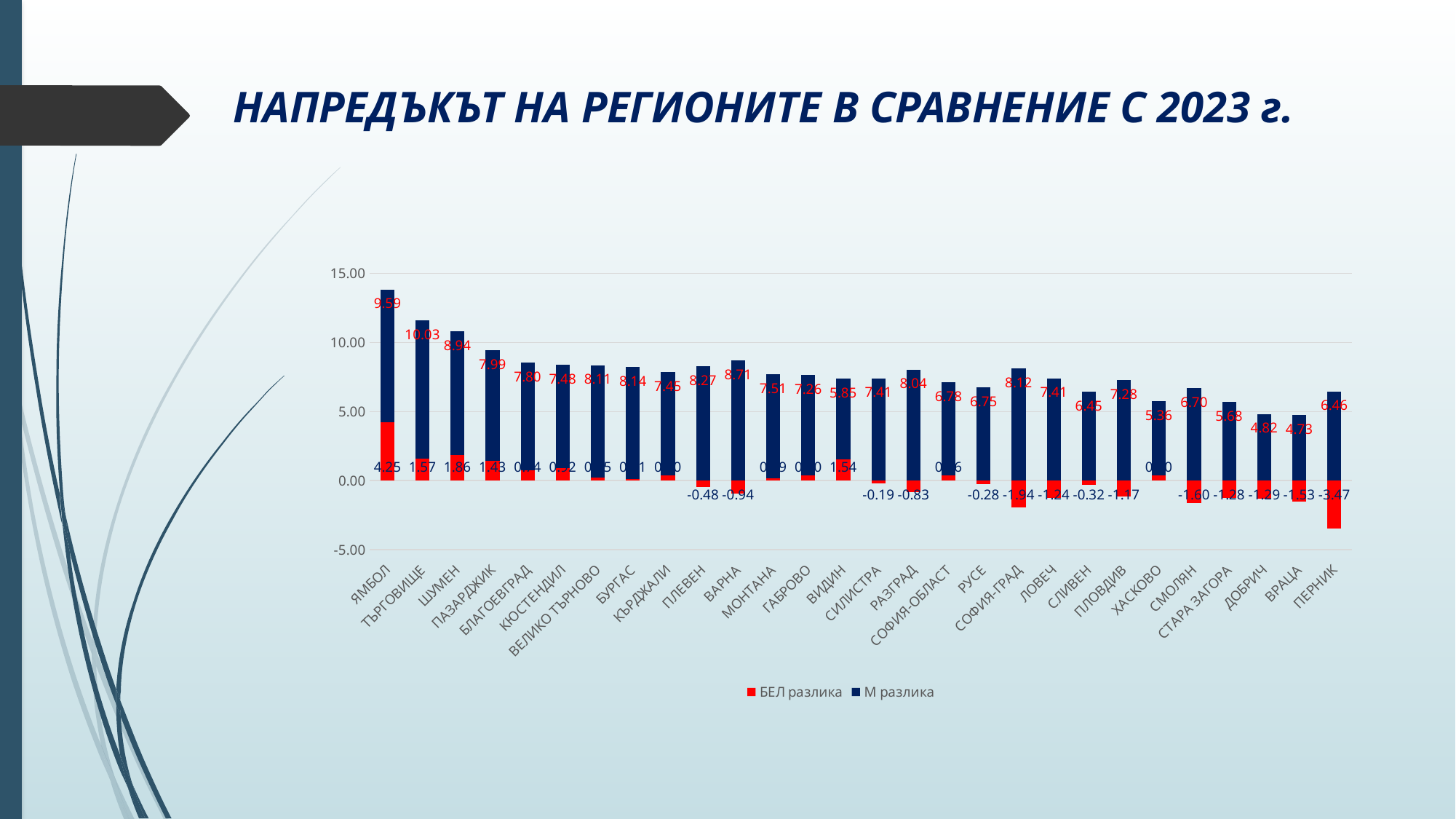
Which region has the highest М разлика value? ТЪРГОВИЩЕ What is the total of the stacked bar for ЯМБОЛ (БЕЛ разлика plus М разлика)? 13.84 What is the value of БЕЛ разлика for ПЕРНИК? -3.47 What is the value of БЕЛ разлика for ЯМБОЛ? 4.25 Which region has the lowest М разлика value? ВРАЦА How many series does the legend list? 2 What is the difference between the М разлика values for ТЪРГОВИЩЕ and ЯМБОЛ? 0.44 How many regions (categories) are shown on the x axis? 28 What is the value of М разлика for ТЪРГОВИЩЕ? 10.03 Which region has the lowest БЕЛ разлика value? ПЕРНИК Which is larger, the М разлика value for ВАРНА or for ПЛЕВЕН? ВАРНА What kind of chart is shown on the slide? bar chart